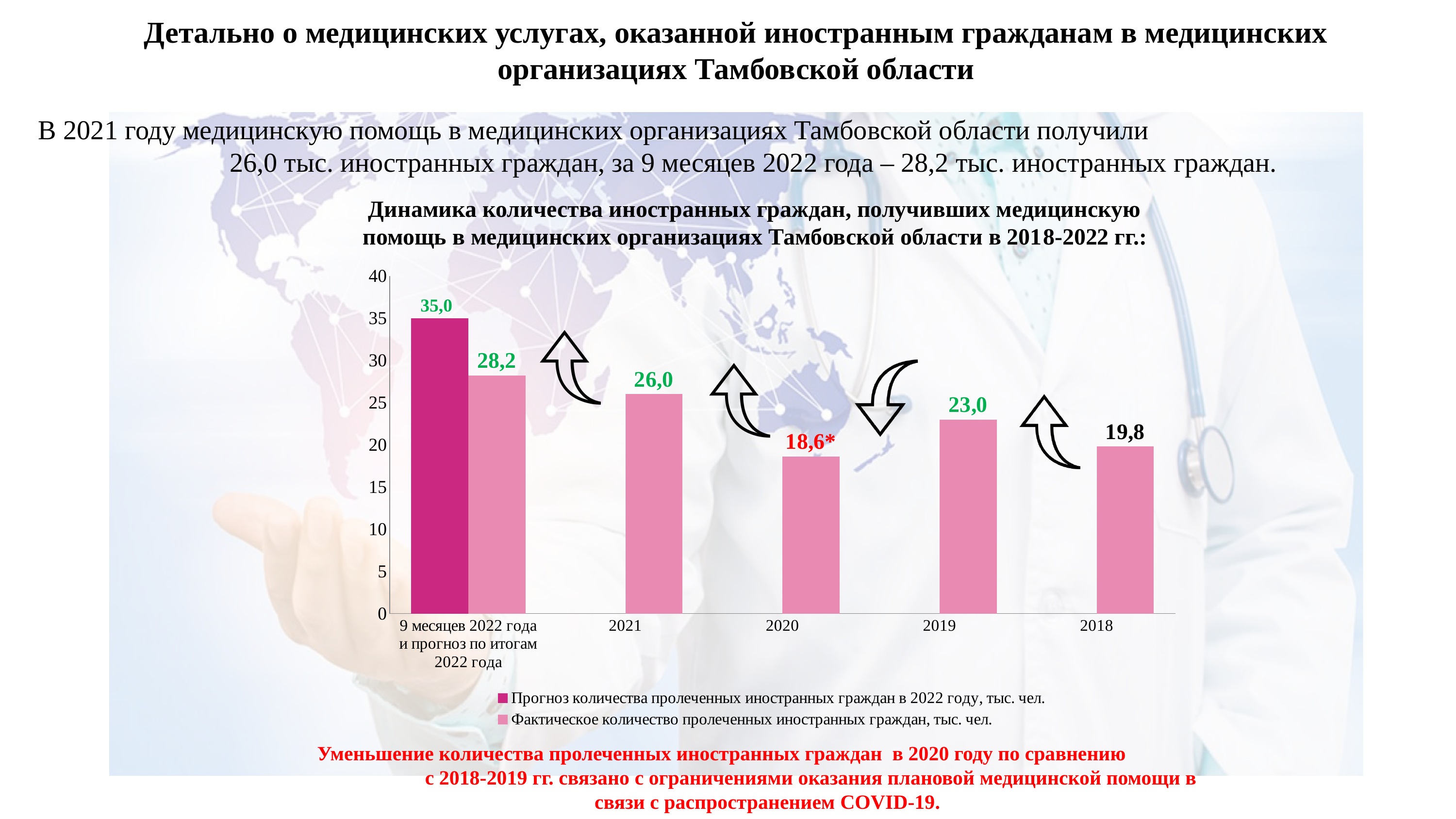
Which bar in the chart is the tallest? Forecast for 2022 (35,0) Which is larger, the value for 2021 or the value for 2019? 2021 What is the actual number of foreign citizens treated in 2021, in thousands? 26,0 What value is shown for 2018? 19,8 How many series does the legend list? 2 What value is shown for 9 months of 2022? 28,2 What is the difference between the 2019 value and the 2018 value? 3,2 Which year among 2018–2021 has the lowest actual number of treated foreign citizens? 2020 What colour is the bar for the 2022 forecast? Dark pink (magenta) Is the value for 2020 greater or less than 20? less What type of chart is shown on the slide? Bar chart What is the forecast number of treated foreign citizens for 2022, in thousands? 35,0